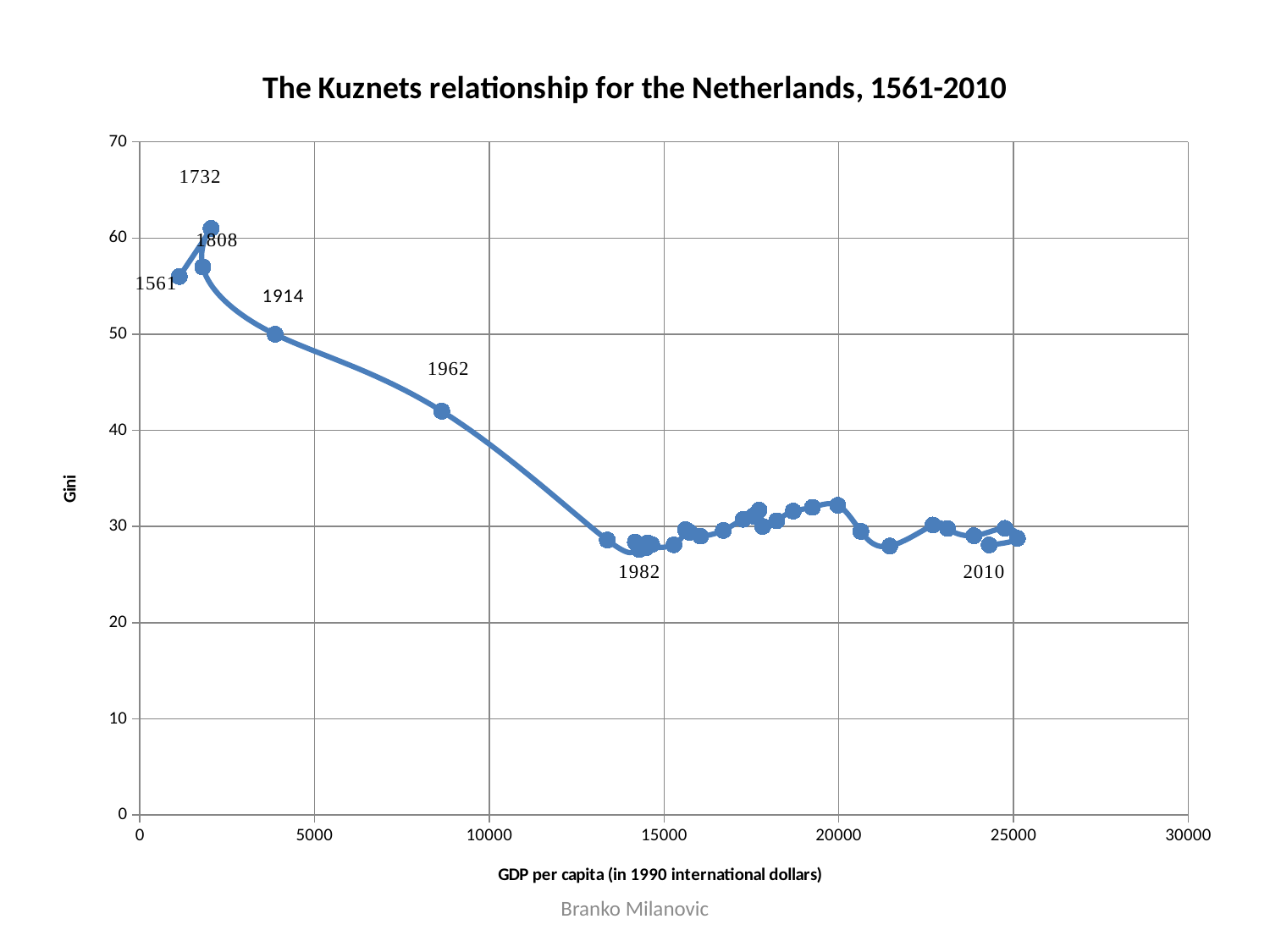
What is the label of the x axis? GDP per capita (in 1990 international dollars) Which has the higher Gini value, the point labelled 1914 or the point labelled 1962? 1914 Is the Gini value for the point labelled 1982 greater or less than 30? less What is the title of the chart? The Kuznets relationship for the Netherlands, 1561-2010 Overall, does the Gini value rise or fall as GDP per capita increases along the x axis? fall Which labelled year has the highest Gini value? 1732 What kind of chart is shown on the slide? line chart Is the Gini value for the point labelled 1962 greater or less than 40? greater Is the Gini value for the point labelled 2010 greater or less than 30? less What is the Gini value for the point labelled 1914? 50 Which has the higher Gini value, the point labelled 1732 or the point labelled 1808? 1732